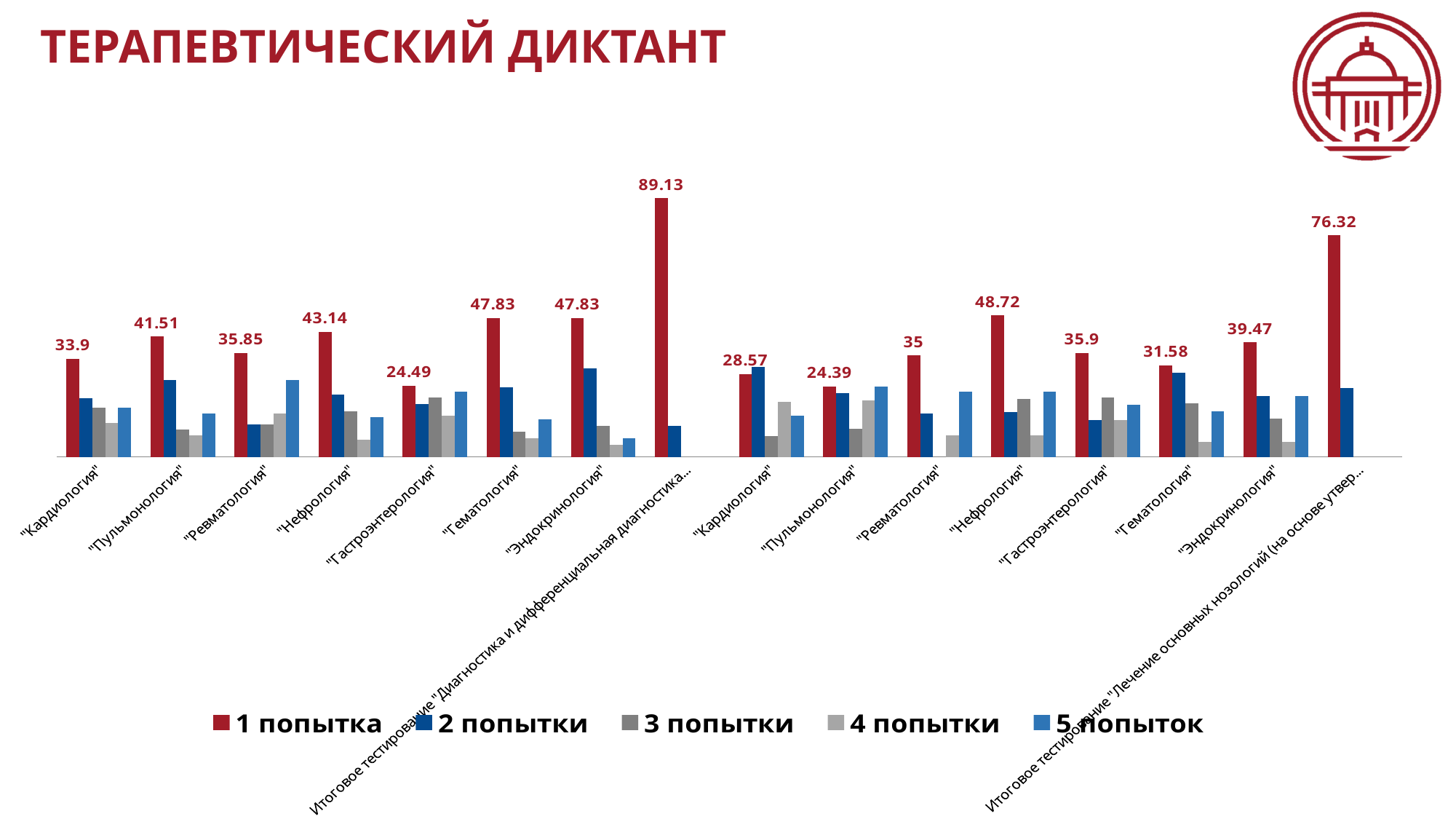
Which "Гематология" category has the larger "1 попытка" value, the first (left group) or the second (right group)? the first (left group) What kind of chart is shown on the slide? bar chart How many series does the legend list? 5 What is the lowest labelled value for "1 попытка" on the chart? 24.39 What is the value of "1 попытка" for the second "Ревматология" category (right group)? 35 What is the difference between the two highest "1 попытка" values, 89.13 and 76.32? 12.81 What is the highest labelled value for "1 попытка" on the chart? 89.13 How many categories are plotted along the x axis? 16 In the right group, what is the difference between the "1 попытка" values for "Нефрология" (48.72) and "Гастроэнтерология" (35.9)? 12.82 What is the value of "1 попытка" for the first "Нефрология" category (left group)? 43.14 What is the first entry in the legend? 1 попытка What is the value of "1 попытка" for the first "Кардиология" category (left group)? 33.9